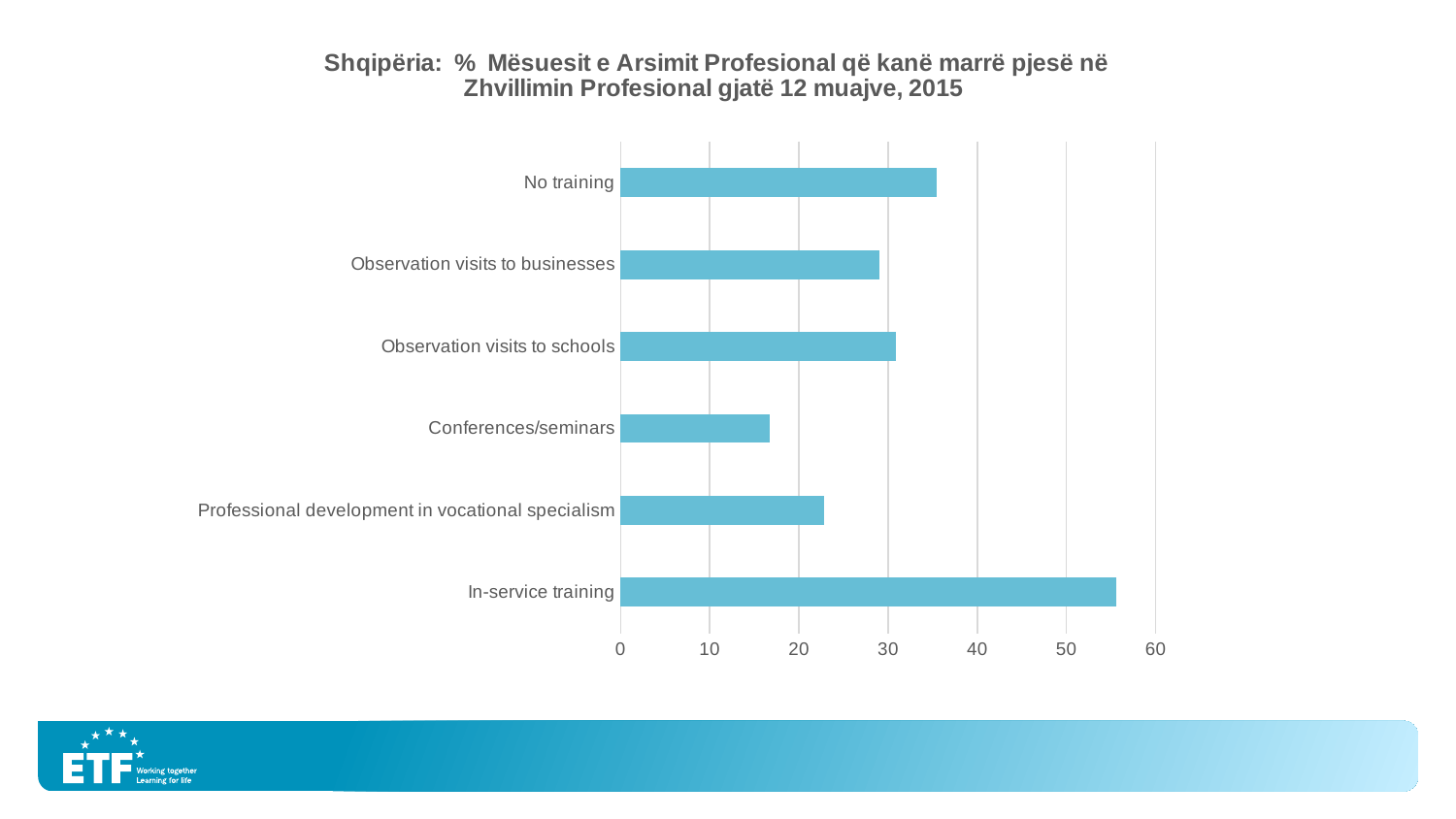
Is the value for Conferences/seminars greater or less than 20? less Is the value for Observation visits to businesses greater or less than 20? greater What is the highest value shown on the horizontal axis? 60 Is the value for In-service training greater or less than 50? greater Which is larger: the value for Conferences/seminars or the value for Professional development in vocational specialism? Professional development in vocational specialism Which is larger: the value for No training or the value for Observation visits to businesses? No training Which category has the lowest value? Conferences/seminars How many categories are plotted in the chart? 6 What kind of chart is shown on the slide? bar chart Which category has the highest value? In-service training